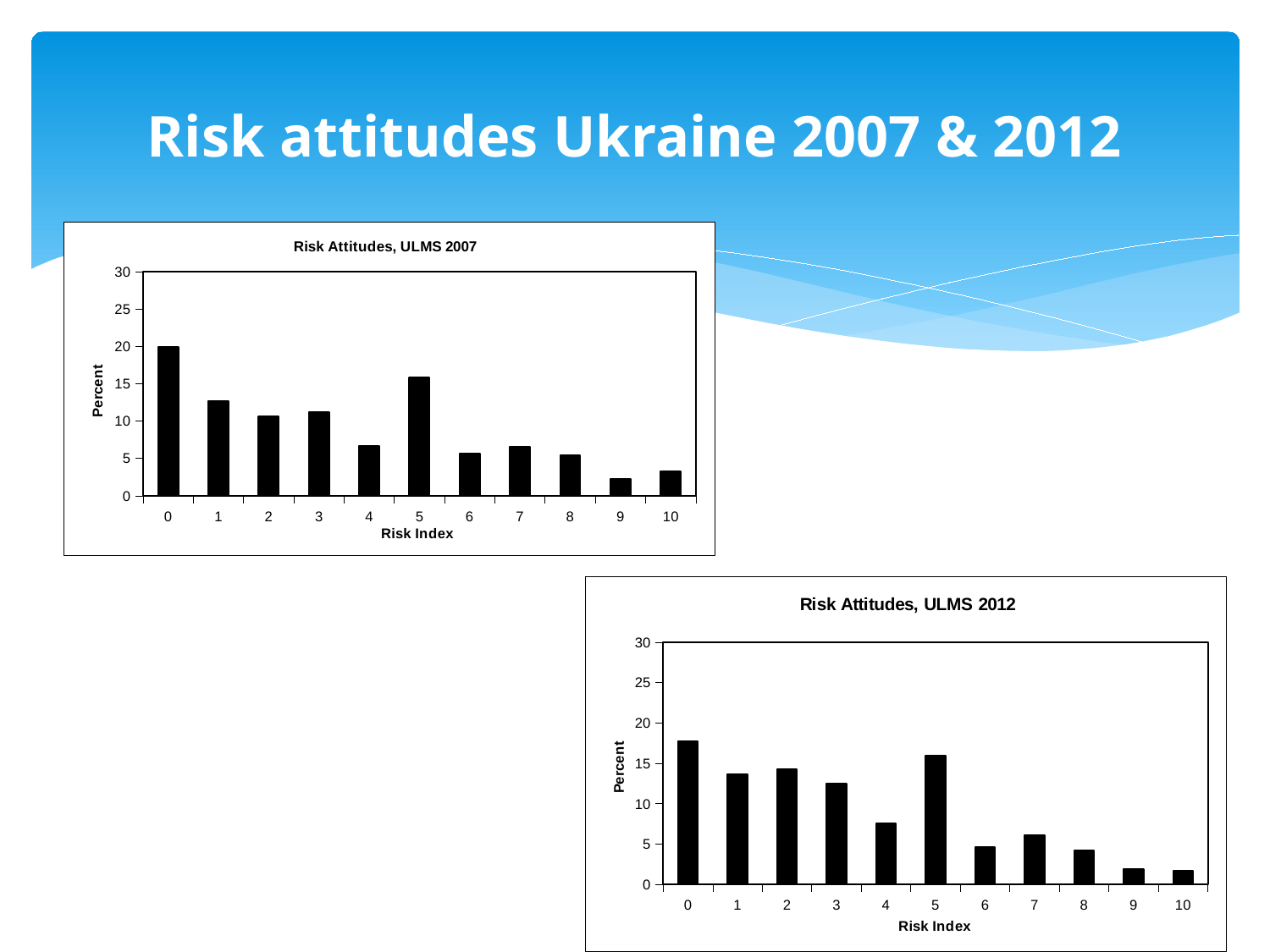
In the 'Risk Attitudes, ULMS 2012' chart, which risk index has the highest percent? 0 In the 'Risk Attitudes, ULMS 2007' chart, is the value for risk index 0 greater or less than 15? greater In the 'Risk Attitudes, ULMS 2012' chart, which has the larger value: risk index 4 or risk index 7? risk index 4 In the 'Risk Attitudes, ULMS 2012' chart, is the value for risk index 9 greater or less than 5? less What kind of chart is the 'Risk Attitudes, ULMS 2007' chart? bar chart In the 'Risk Attitudes, ULMS 2012' chart, is the value for risk index 2 greater or less than 10? greater In the 'Risk Attitudes, ULMS 2007' chart, which risk index has the lowest percent? 9 In the 'Risk Attitudes, ULMS 2007' chart, which risk index has the highest percent? 0 How many risk index categories are shown in the 'Risk Attitudes, ULMS 2007' chart? 11 In the 'Risk Attitudes, ULMS 2007' chart, which has the larger value: risk index 1 or risk index 5? risk index 5 What is the label on the vertical axis of the 'Risk Attitudes, ULMS 2012' chart? Percent